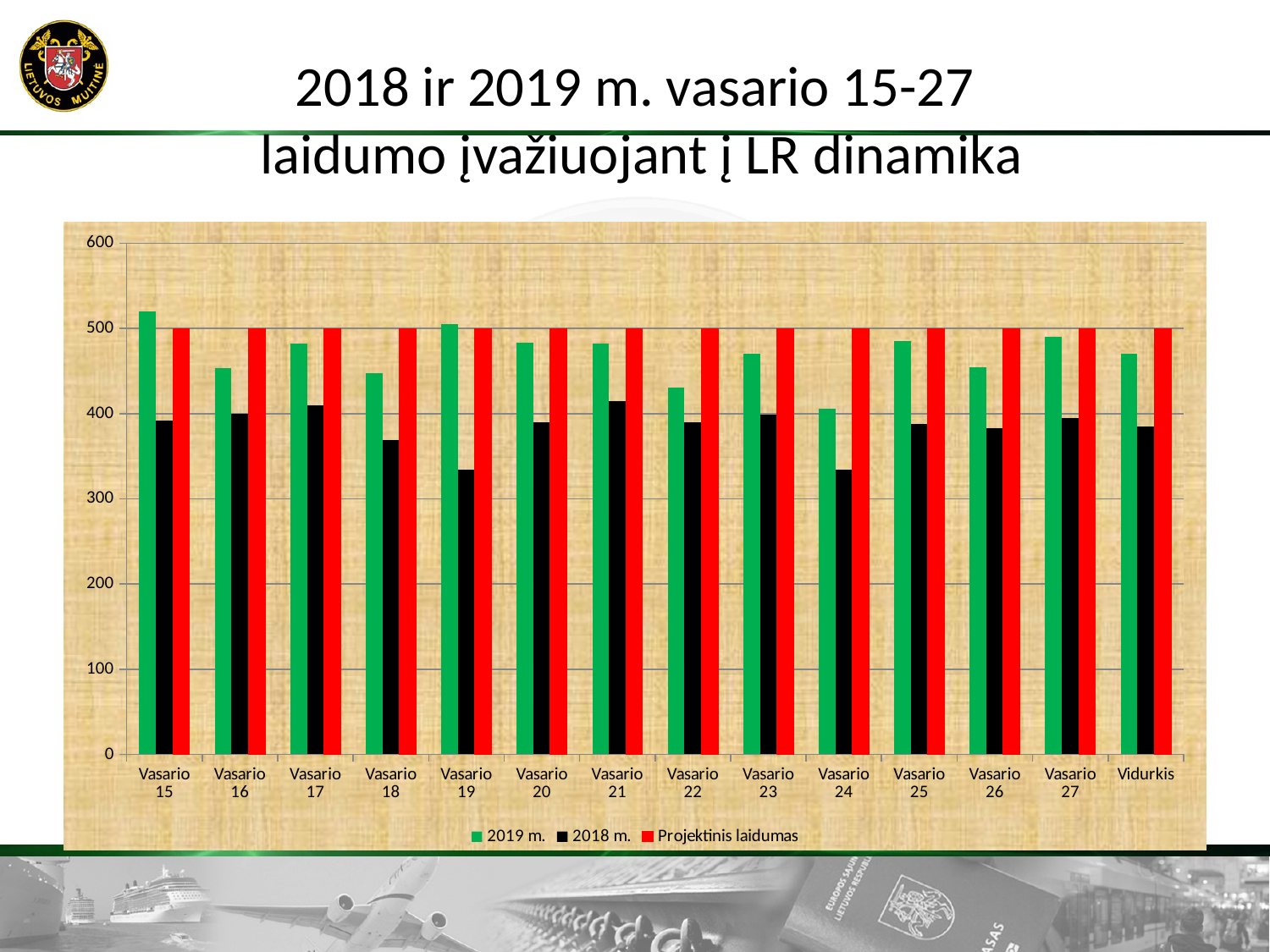
For Vasario 16, which series has the larger value, 2019 m. or 2018 m.? 2019 m. What kind of chart is shown on the slide? bar chart How many series does the legend list? 3 What is the value of Projektinis laidumas for Vasario 20? 500 Which category has the highest value for the 2019 m. series? Vasario 15 Which category has the lowest value for the 2019 m. series? Vasario 24 How many categories are shown along the x axis? 14 Is the 2019 m. value for Vasario 22 greater or less than 500? less Which series is shown in red in the legend? Projektinis laidumas Is the 2018 m. value for Vasario 18 greater or less than 400? less Is the 2018 m. value for Vasario 19 greater or less than 400? less